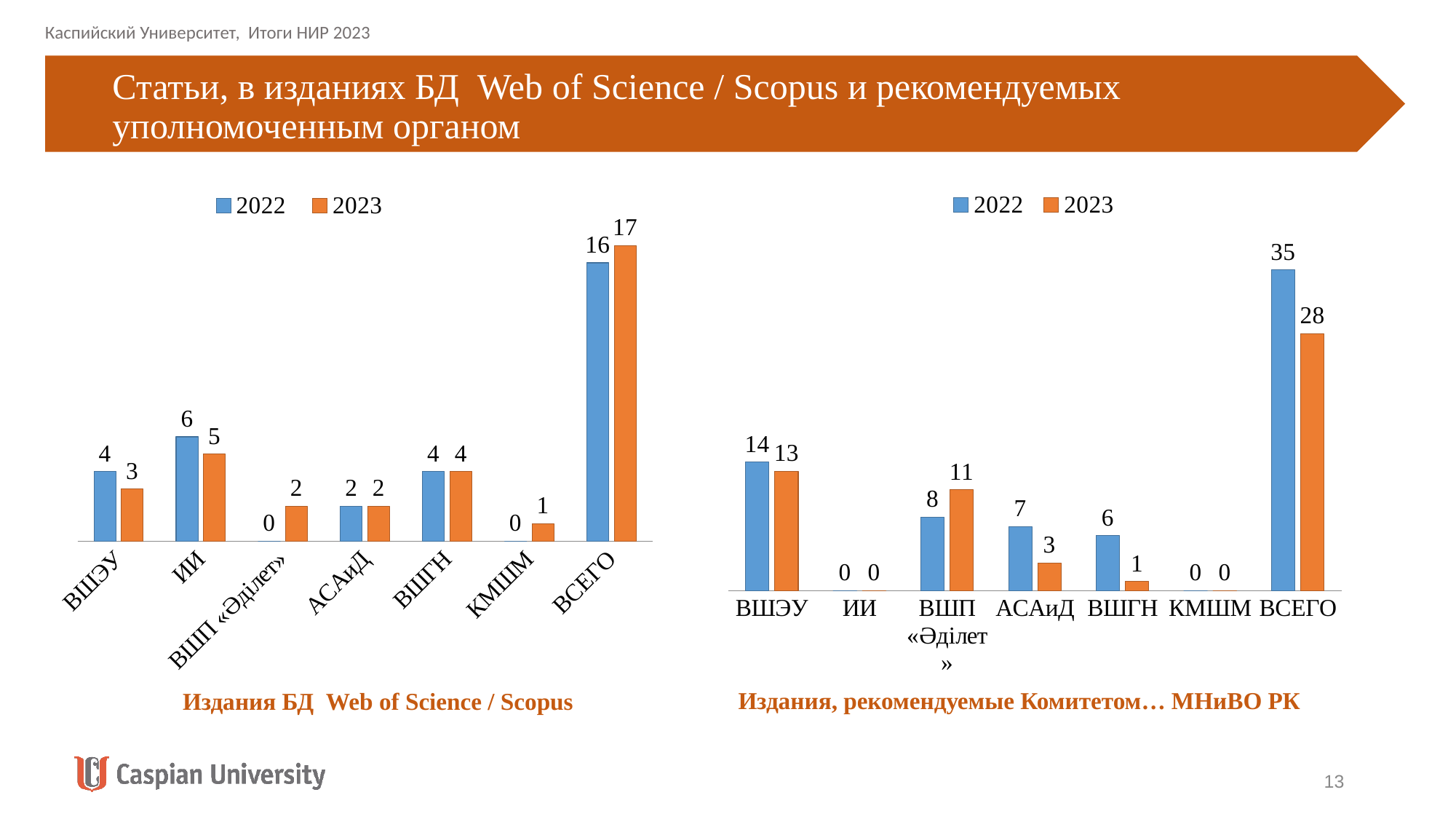
In the left chart (Издания БД Web of Science / Scopus), what is the value for ВШП «Әділет» in 2022? 0 In the left chart (Издания БД Web of Science / Scopus), how many series does the legend list? 2 What type of chart is the right chart (Издания, рекомендуемые Комитетом… МНиВО РК)? Bar chart In the left chart (Издания БД Web of Science / Scopus), what is the value for ИИ in 2022? 6 In the left chart (Издания БД Web of Science / Scopus), what is the value for ВСЕГО in 2023? 17 In the right chart (Издания, рекомендуемые Комитетом… МНиВО РК), what is the value for ВШП «Әділет» in 2023? 11 In the left chart (Издания БД Web of Science / Scopus), what is the difference between the 2022 and 2023 values for ВШЭУ? 1 In the right chart (Издания, рекомендуемые Комитетом… МНиВО РК), which is larger for АСАиД: the 2022 value or the 2023 value? 2022 In the right chart (Издания, рекомендуемые Комитетом… МНиВО РК), what is the difference between the 2022 and 2023 values for ВСЕГО? 7 In the left chart (Издания БД Web of Science / Scopus), which category has the highest 2023 value? ВСЕГО In the right chart (Издания, рекомендуемые Комитетом… МНиВО РК), what is the value for ВСЕГО in 2022? 35 In the right chart (Издания, рекомендуемые Комитетом… МНиВО РК), how many categories are shown on the x axis? 7